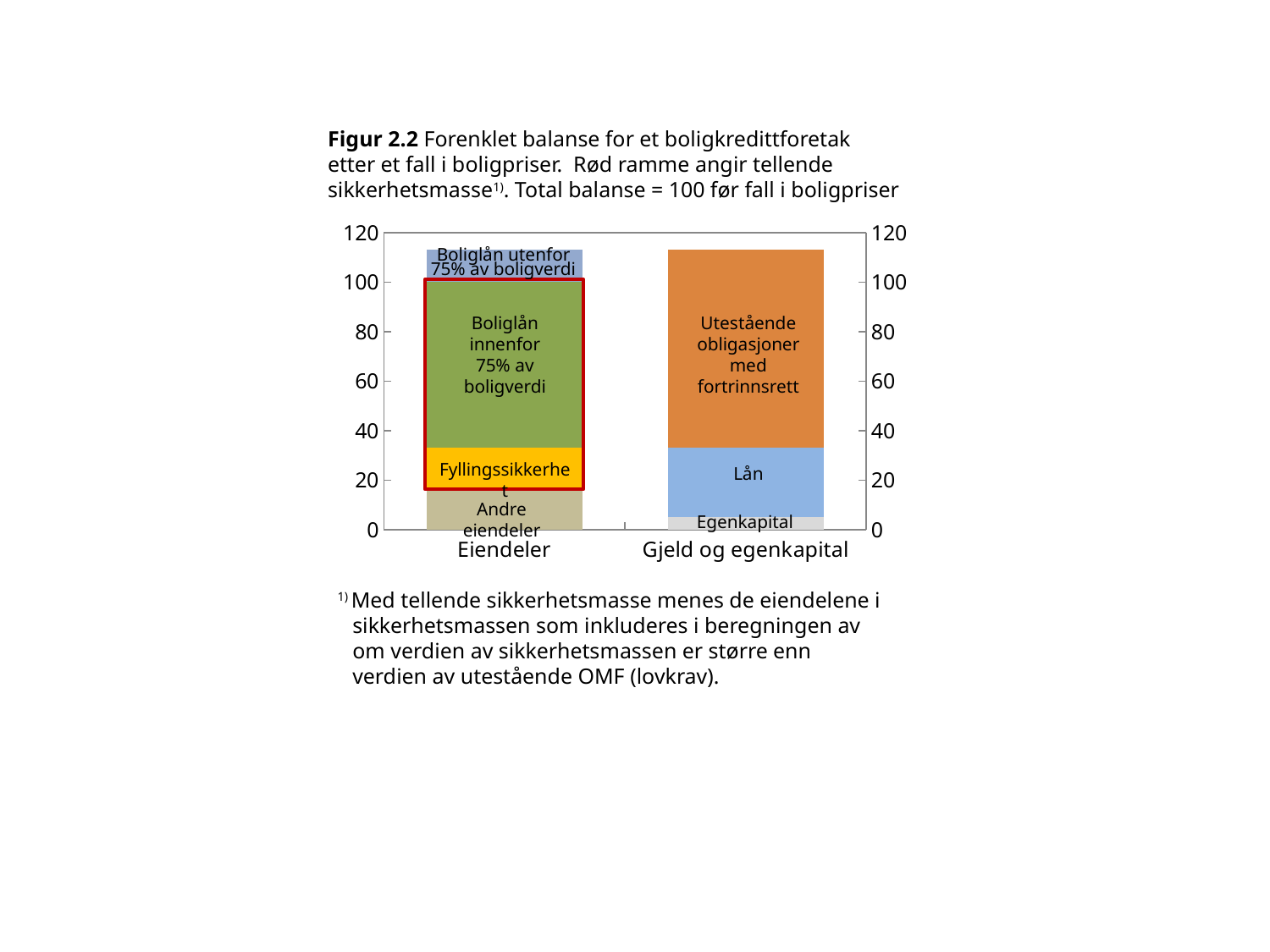
Which segment is the smallest in the Gjeld og egenkapital bar? Egenkapital What is the maximum value shown on the y axis? 120 Which segment is larger in the Gjeld og egenkapital bar: Utestående obligasjoner med fortrinnsrett or Lån? Utestående obligasjoner med fortrinnsrett What kind of chart is shown on the slide? Stacked bar chart Which segment of the Eiendeler bar sits at the top? Boliglån utenfor 75% av boligverdi Is the total height of the Eiendeler bar greater or less than 100? greater Is the top of the Egenkapital segment greater or less than 20? less How many bars (categories) are shown on the x axis? 2 Which segment is the largest in the Eiendeler bar? Boliglån innenfor 75% av boligverdi What are the two categories on the x axis? Eiendeler; Gjeld og egenkapital Which segment of the Eiendeler bar sits at the bottom? Andre eiendeler Is the top of the Lån segment greater or less than 40? less